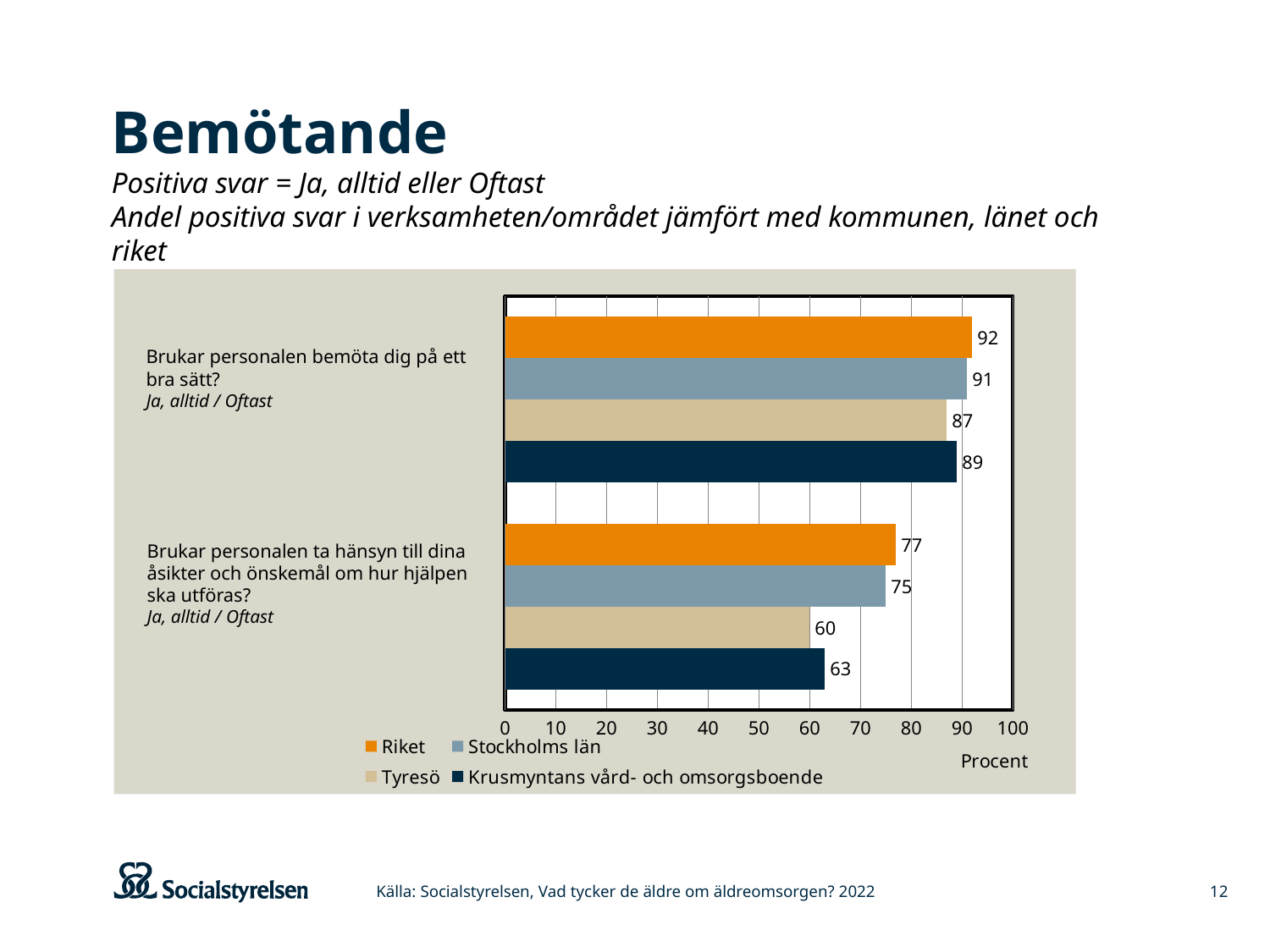
What kind of chart is shown on the slide? Bar chart What is the difference between Riket and Krusmyntans vård- och omsorgsboende on the question "Brukar personalen ta hänsyn till dina åsikter och önskemål om hur hjälpen ska utföras?"? 14 Which is larger on the question "Brukar personalen ta hänsyn till dina åsikter och önskemål om hur hjälpen ska utföras?": Tyresö or Krusmyntans vård- och omsorgsboende? Krusmyntans vård- och omsorgsboende How many series does the legend list? 4 What is the value for Stockholms län on the question "Brukar personalen ta hänsyn till dina åsikter och önskemål om hur hjälpen ska utföras?"? 75 What is the value for Tyresö on the question "Brukar personalen ta hänsyn till dina åsikter och önskemål om hur hjälpen ska utföras?"? 60 Which series has the highest value on the question "Brukar personalen ta hänsyn till dina åsikter och önskemål om hur hjälpen ska utföras?"? Riket Is the value for Stockholms län on the question "Brukar personalen bemöta dig på ett bra sätt?" greater or less than 80? greater What is the value for Riket on the question "Brukar personalen bemöta dig på ett bra sätt?"? 92 Which series has the lowest value on the question "Brukar personalen bemöta dig på ett bra sätt?"? Tyresö What is the label on the horizontal axis of the chart? Procent What is the value for Krusmyntans vård- och omsorgsboende on the question "Brukar personalen bemöta dig på ett bra sätt?"? 89